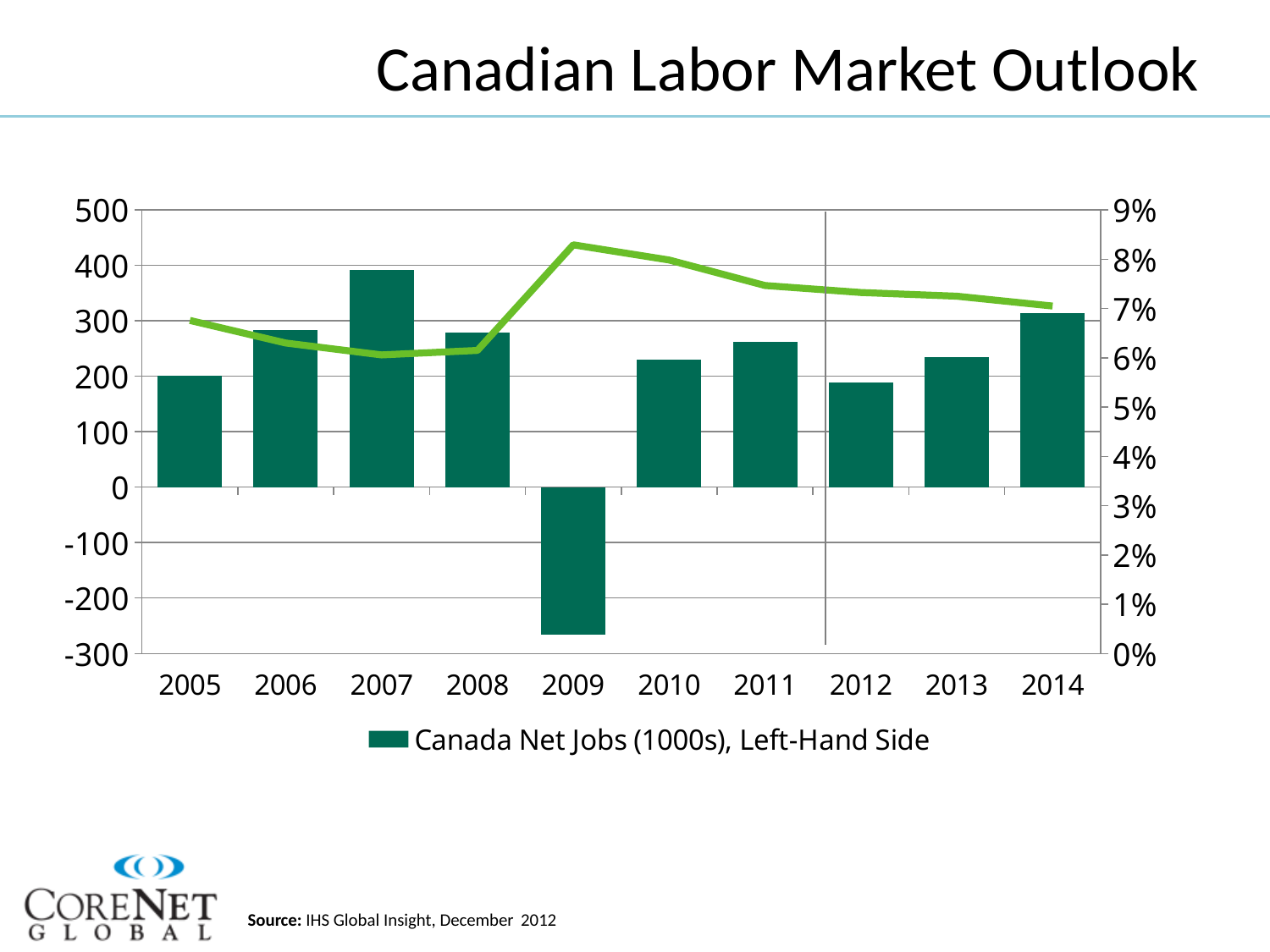
Is the value for Canada Net Jobs in 2014 greater or less than 300? greater How many years are shown on the x axis of the chart? 10 Which year has the highest value for Canada Net Jobs (1000s)? 2007 Is the value for Canada Net Jobs in 2005 greater or less than 300? less What is the title of the slide containing the chart? Canadian Labor Market Outlook Which year has the larger value for Canada Net Jobs, 2012 or 2014? 2014 How many series does the legend list? 1 What kind of chart is used to plot Canada Net Jobs (1000s)? bar chart Is the value for Canada Net Jobs in 2009 greater or less than 0? less Which year has the larger value for Canada Net Jobs, 2007 or 2005? 2007 Which year has the lowest value for Canada Net Jobs (1000s)? 2009